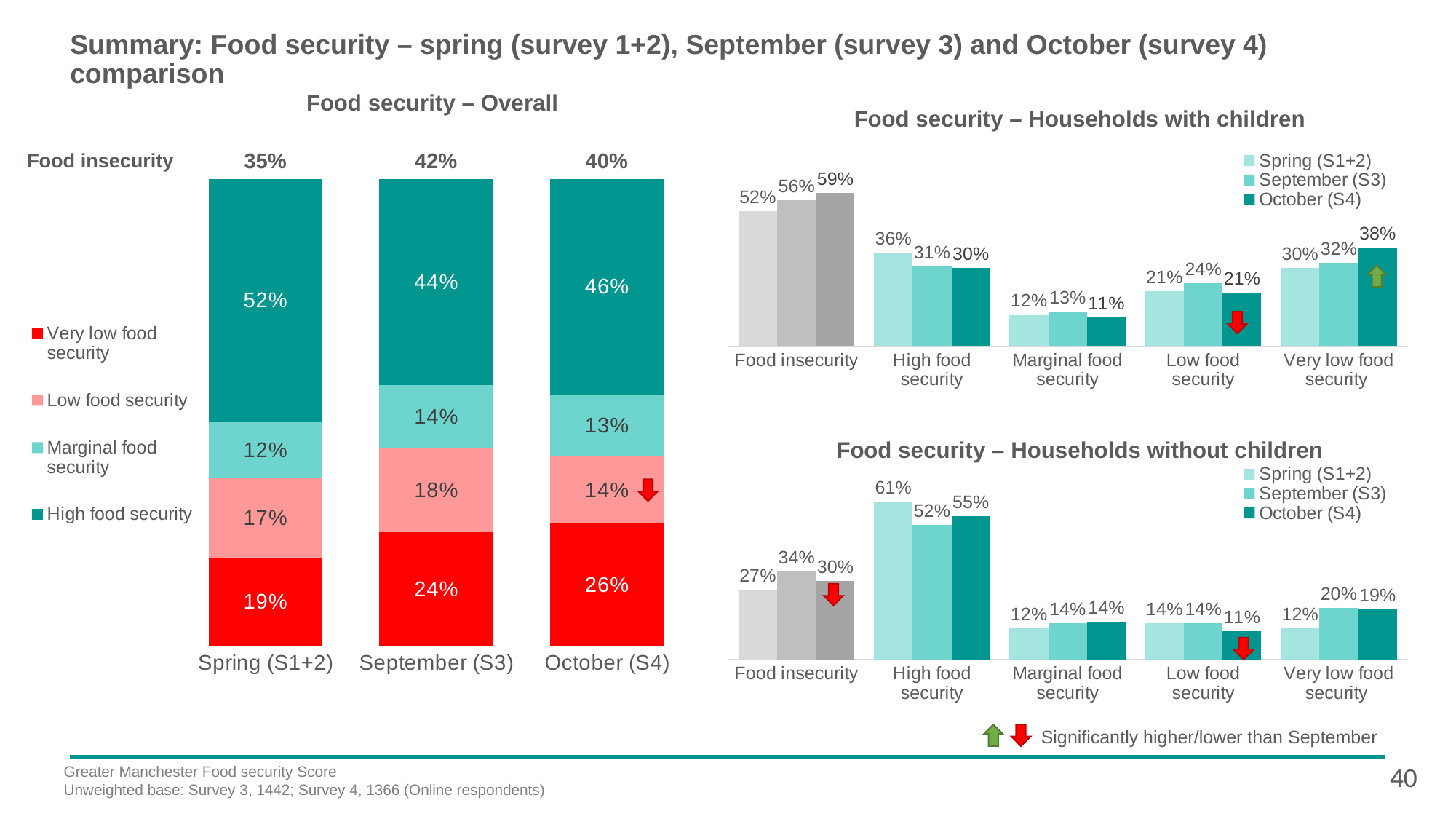
In the 'Food security – Households with children' chart, what is the October (S4) value for Very low food security? 38% In the 'Food security – Overall' chart, what is the value for High food security in September (S3)? 44% In the 'Food security – Overall' chart, how many series does the legend list? 4 In the 'Food security – Overall' chart, what is the difference between the Low food security values for September (S3) and October (S4)? 4% In the 'Food security – Households with children' chart, which survey period has the lowest Marginal food security value? October (S4) In the 'Food security – Households without children' chart, what is the Spring (S1+2) value for High food security? 61% In the 'Food security – Overall' chart, what is the value for Very low food security in October (S4)? 26% In the 'Food security – Households with children' chart, is the Spring (S1+2) value for High food security larger or smaller than the October (S4) value? larger What kind of chart is 'Food security – Overall'? Stacked bar chart In the 'Food security – Households without children' chart, how many categories are shown on the x axis? 5 In the 'Food security – Overall' chart, which survey period has the highest Very low food security value? October (S4) In the 'Food security – Households without children' chart, what is the difference between the September (S3) and October (S4) values for Food insecurity? 4%